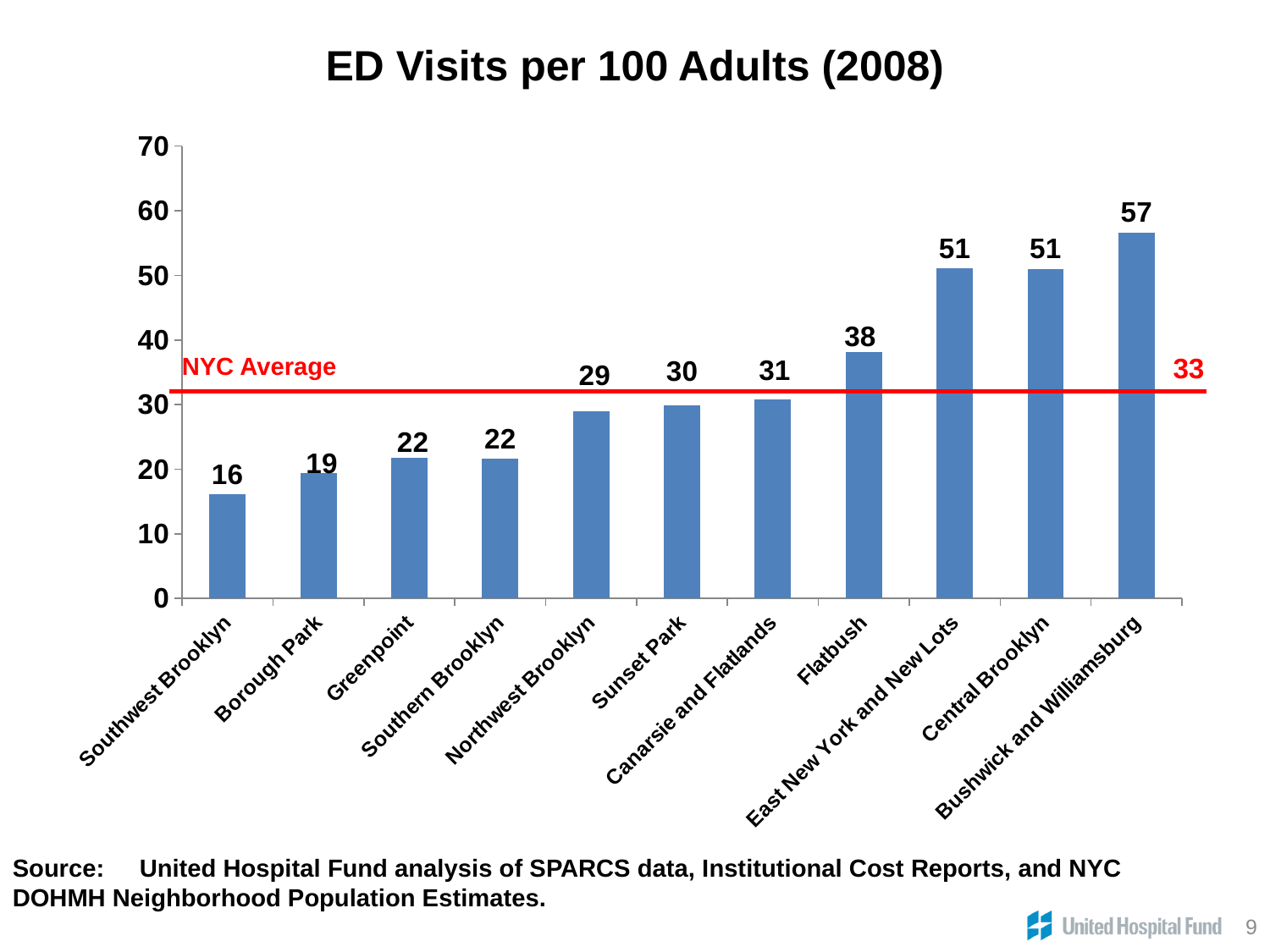
What is the value for Flatbush? 38 What value is shown for the NYC Average line? 33 Which neighborhood has the highest ED visits per 100 adults? Bushwick and Williamsburg What is the value for Sunset Park? 30 Which is larger, the value for Flatbush or the value for Canarsie and Flatlands? Flatbush How many neighborhoods are shown on the chart? 11 Do the values rise or fall from left to right along the x axis? Rise What is the difference between the values for Bushwick and Williamsburg and Southwest Brooklyn? 41 Is the value for Central Brooklyn greater or less than 40? greater What kind of chart is shown on the slide? Bar chart What is the value for Southwest Brooklyn? 16 Which neighborhood has the lowest ED visits per 100 adults? Southwest Brooklyn